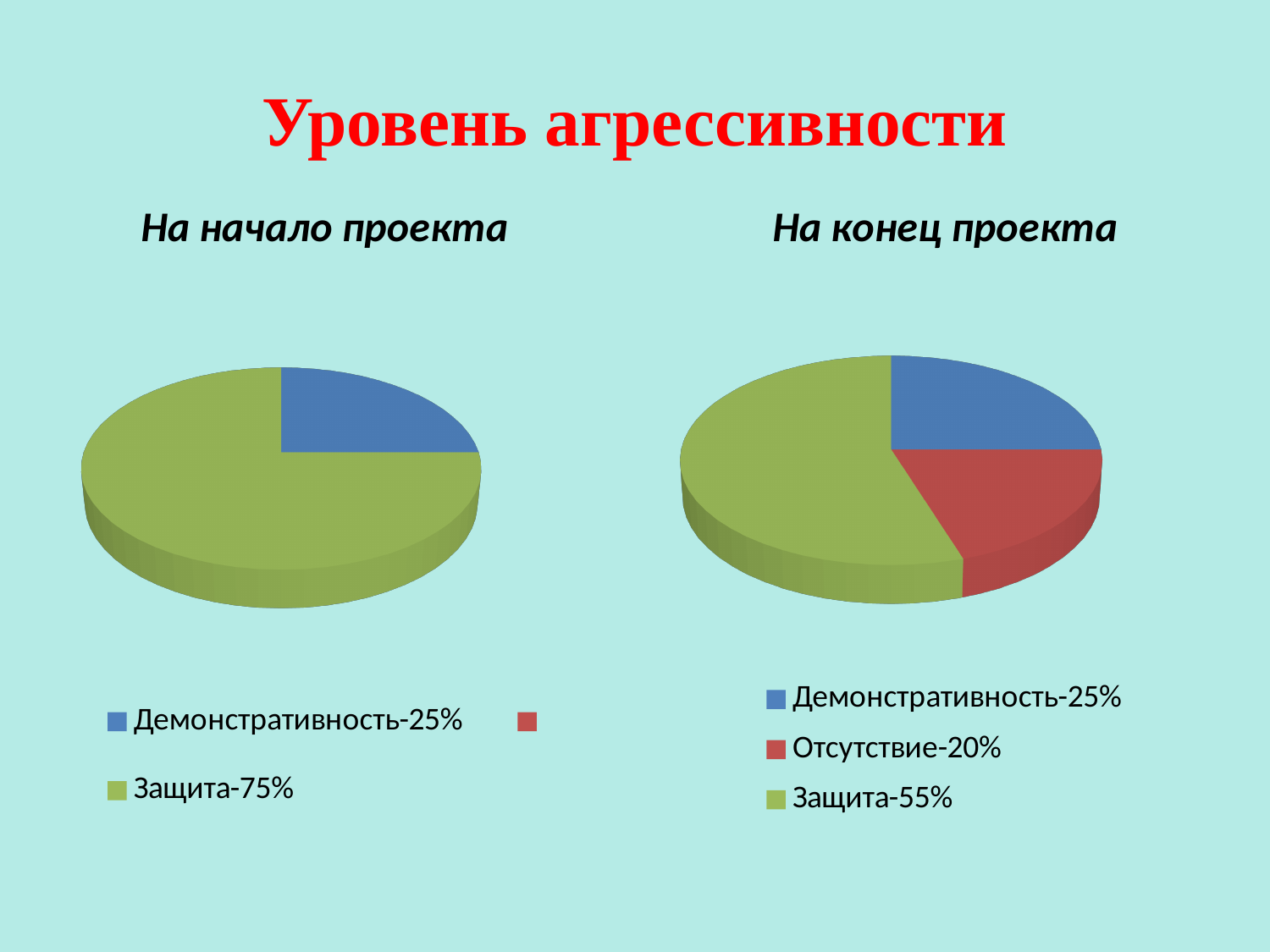
In the 'На конец проекта' chart, what is the difference between the shares of 'Защита' and 'Демонстративность'? 30% What kind of chart is used on the slide for 'На начало проекта'? pie chart What is the title of the slide? Уровень агрессивности In the 'На начало проекта' chart, which is larger: 'Защита' or 'Демонстративность'? Защита In the 'На конец проекта' chart, which category has the largest slice? Защита In the 'На начало проекта' chart, what share does 'Защита' have? 75% By how much did the share of 'Защита' change from the 'На начало проекта' chart to the 'На конец проекта' chart? 20% In the 'На начало проекта' chart, what share does 'Демонстративность' have? 25% In the 'На конец проекта' chart, which category has the smallest slice? Отсутствие How many labelled categories does the legend of the 'На конец проекта' chart list? 3 In the 'На конец проекта' chart, what share does 'Отсутствие' have? 20% In the 'На конец проекта' chart, what share does 'Защита' have? 55%